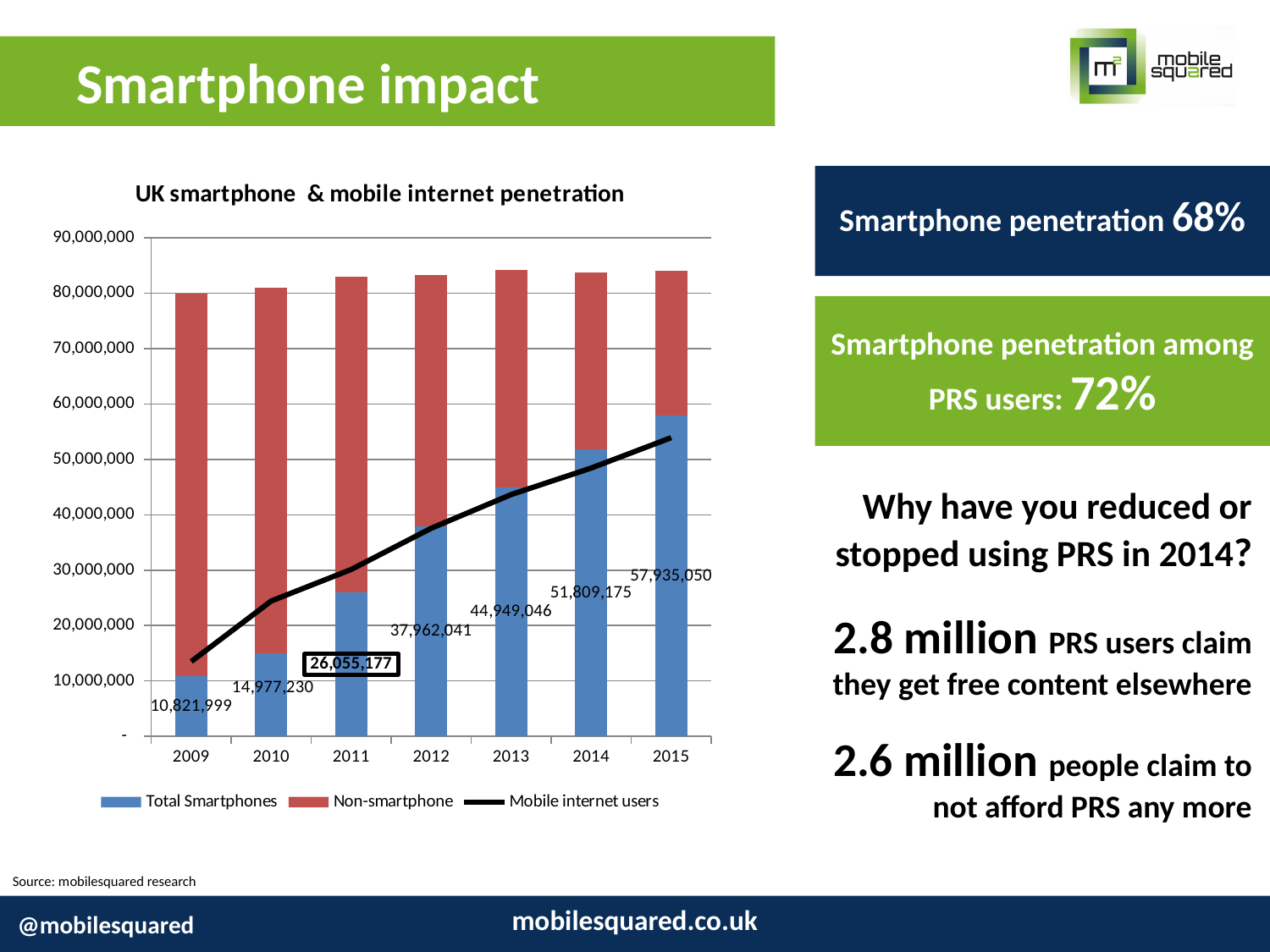
Do the Total Smartphones values rise or fall from 2009 to 2015? rise What is the title of the chart? UK smartphone & mobile internet penetration How many years are shown on the x axis? 7 Which year has the lowest value for Total Smartphones? 2009 What is the value for Total Smartphones in 2015? 57,935,050 What is the value for Total Smartphones in 2011? 26,055,177 What is the difference between the Total Smartphones values for 2015 and 2009? 47,113,051 How many series does the legend list? 3 Which is larger, the Total Smartphones value for 2012 or for 2013? 2013 Which year has the highest value for Total Smartphones? 2015 What is the value for Total Smartphones in 2009? 10,821,999 Is the value for Mobile internet users in 2015 greater or less than 50,000,000? greater